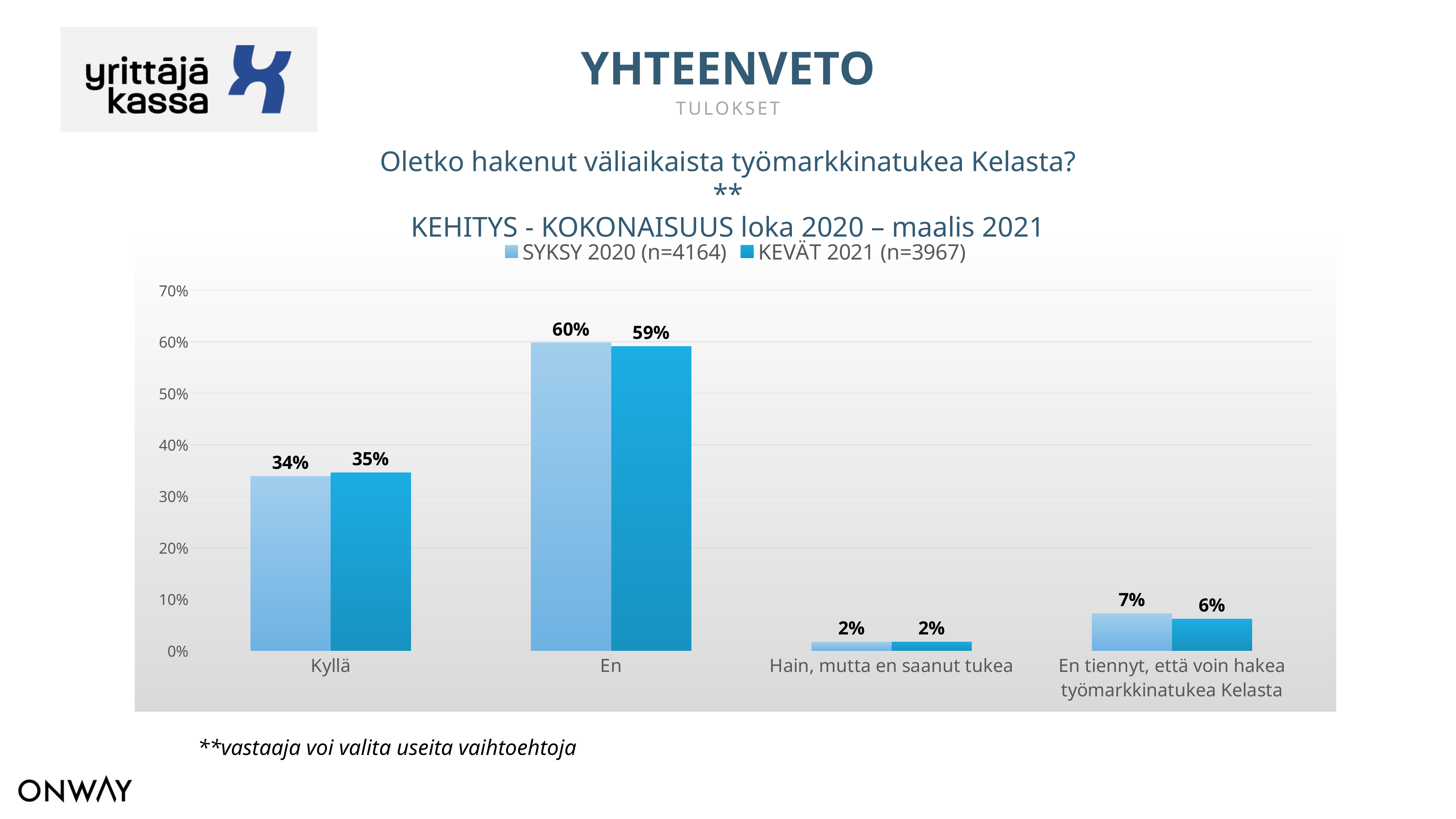
What is the value for En tiennyt, että voin hakea työmarkkinatukea Kelasta in the KEVÄT 2021 (n=3967) series? 6% What is the value for Kyllä in the SYKSY 2020 (n=4164) series? 34% Which category has the lowest value in the SYKSY 2020 (n=4164) series? Hain, mutta en saanut tukea What is the sample size (n) given in the legend for SYKSY 2020? 4164 What is the value for En in the SYKSY 2020 (n=4164) series? 60% How many series does the legend list? 2 Which category has the highest value in the KEVÄT 2021 (n=3967) series? En Which is larger for Kyllä: the SYKSY 2020 (n=4164) value or the KEVÄT 2021 (n=3967) value? KEVÄT 2021 (n=3967) What kind of chart is shown on the slide? bar chart What is the value for Kyllä in the KEVÄT 2021 (n=3967) series? 35% What is the difference between the SYKSY 2020 (n=4164) and KEVÄT 2021 (n=3967) values for En? 1% How many categories are shown on the x axis? 4